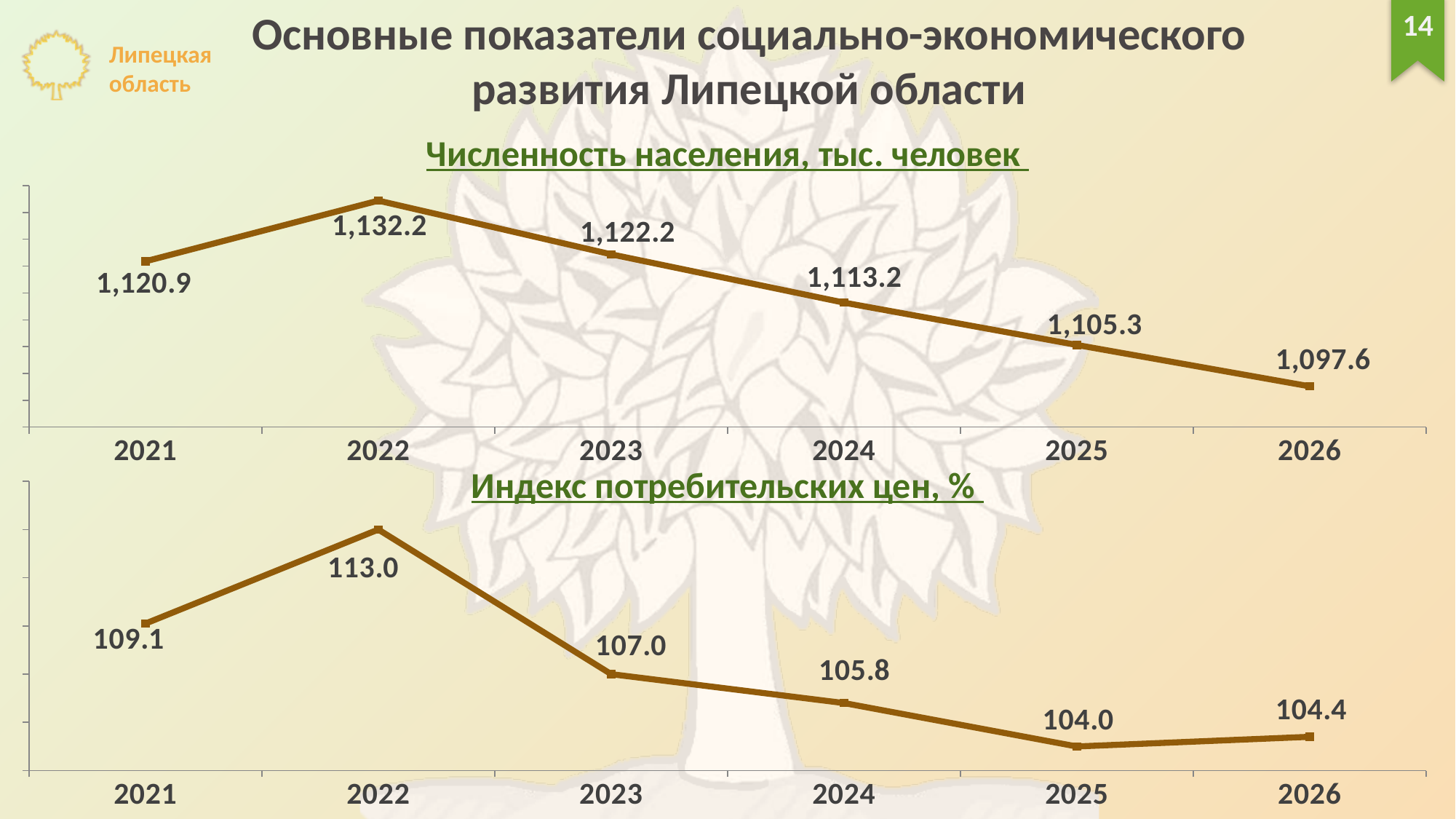
In the chart 'Индекс потребительских цен, %', what is the difference between the 2022 and 2023 values? 6.0 In the chart 'Численность населения, тыс. человек', what is the value for 2026? 1,097.6 What type of chart is the chart 'Индекс потребительских цен, %'? Line chart In the chart 'Численность населения, тыс. человек', what is the value for 2022? 1,132.2 In the chart 'Численность населения, тыс. человек', how many data points are plotted? 6 In the chart 'Индекс потребительских цен, %', which year has the highest value? 2022 In the chart 'Индекс потребительских цен, %', what is the value for 2023? 107.0 In the chart 'Индекс потребительских цен, %', which year has the lowest value? 2025 In the chart 'Численность населения, тыс. человек', what is the difference between the 2022 and 2026 values? 34.6 In the chart 'Численность населения, тыс. человек', which year has the highest value? 2022 In the chart 'Индекс потребительских цен, %', which is larger, the value for 2021 or the value for 2024? 2021 In the chart 'Численность населения, тыс. человек', which year has the lowest value? 2026